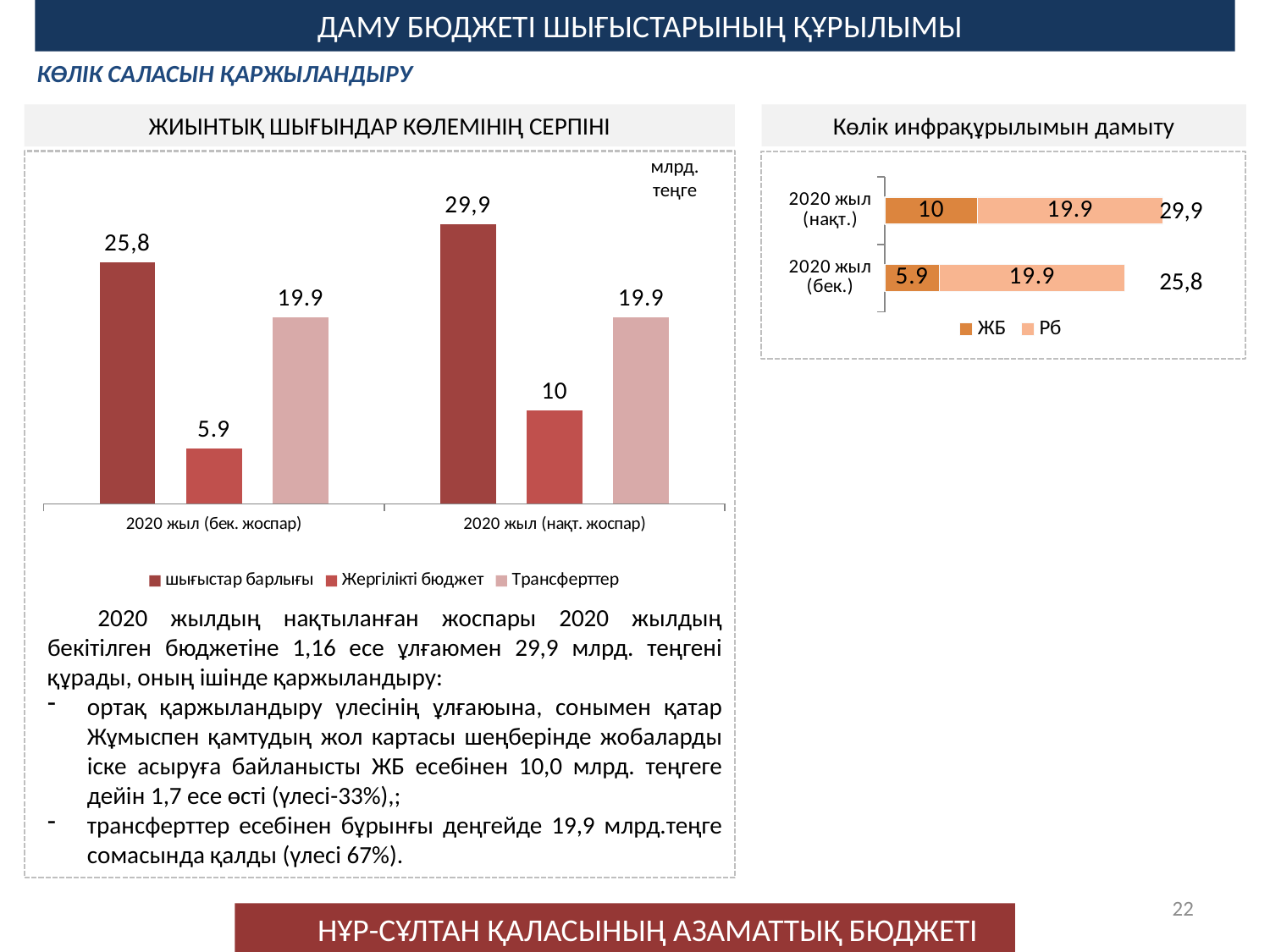
In the chart titled 'Көлік инфрақұрылымын дамыту', which series is shown in the darker orange colour? ЖБ In the chart titled 'ЖИЫНТЫҚ ШЫҒЫНДАР КӨЛЕМІНІҢ СЕРПІНІ', what is the value of 'Трансферттер' for '2020 жыл (нақт. жоспар)'? 19.9 In the chart titled 'ЖИЫНТЫҚ ШЫҒЫНДАР КӨЛЕМІНІҢ СЕРПІНІ', what is the difference between 'Жергілікті бюджет' for '2020 жыл (нақт. жоспар)' and for '2020 жыл (бек. жоспар)'? 4.1 In the chart titled 'ЖИЫНТЫҚ ШЫҒЫНДАР КӨЛЕМІНІҢ СЕРПІНІ', how many series does the legend list? 3 In the chart titled 'ЖИЫНТЫҚ ШЫҒЫНДАР КӨЛЕМІНІҢ СЕРПІНІ', is the value of 'Жергілікті бюджет' for '2020 жыл (нақт. жоспар)' larger or smaller than for '2020 жыл (бек. жоспар)'? Larger In the chart titled 'ЖИЫНТЫҚ ШЫҒЫНДАР КӨЛЕМІНІҢ СЕРПІНІ', what is the value of 'Жергілікті бюджет' for '2020 жыл (бек. жоспар)'? 5.9 In the chart titled 'ЖИЫНТЫҚ ШЫҒЫНДАР КӨЛЕМІНІҢ СЕРПІНІ', which series has the lowest value for '2020 жыл (бек. жоспар)'? Жергілікті бюджет In the chart titled 'ЖИЫНТЫҚ ШЫҒЫНДАР КӨЛЕМІНІҢ СЕРПІНІ', what is the value of 'шығыстар барлығы' for '2020 жыл (нақт. жоспар)'? 29,9 In the chart titled 'Көлік инфрақұрылымын дамыту', what is the value of 'ЖБ' for '2020 жыл (бек.)'? 5.9 In the chart titled 'ЖИЫНТЫҚ ШЫҒЫНДАР КӨЛЕМІНІҢ СЕРПІНІ', what kind of chart is shown? Bar chart In the chart titled 'Көлік инфрақұрылымын дамыту', how many series does the legend list? 2 In the chart titled 'Көлік инфрақұрылымын дамыту', what is the total of the stacked bar for '2020 жыл (нақт.)'? 29,9